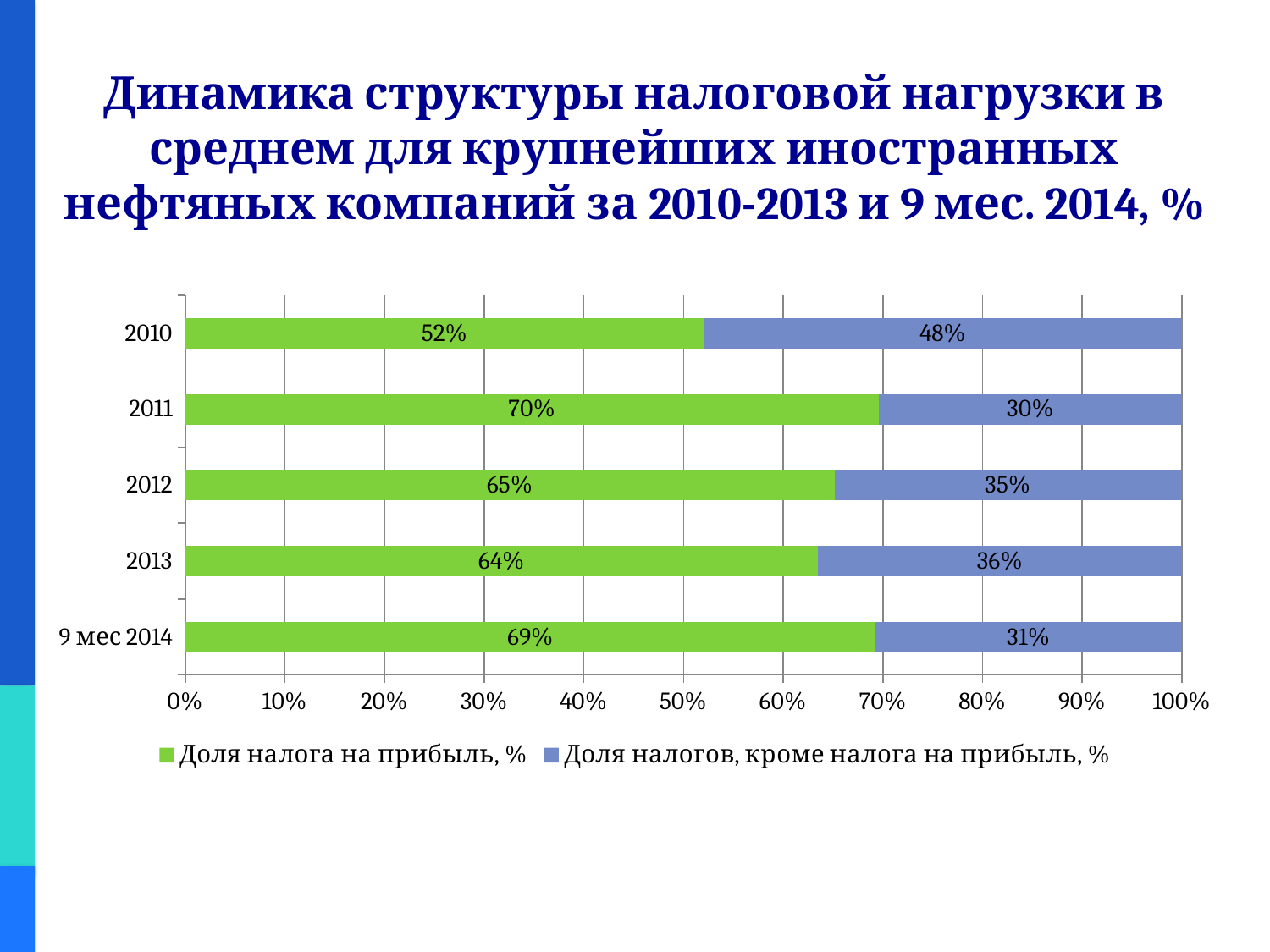
What is the total of the stacked bar for 2012? 100% What kind of chart is shown on the slide? Stacked bar chart How many series does the legend list? 2 How many categories are shown on the y axis? 5 Which category has the lowest value for 'Доля налогов, кроме налога на прибыль, %'? 2011 Which is larger: 'Доля налогов, кроме налога на прибыль, %' in 2012 or in 2013? 2013 What is the value of 'Доля налога на прибыль, %' for 2010? 52% What is the difference between 'Доля налога на прибыль, %' in 2011 and in 2010? 18% What is the value of 'Доля налога на прибыль, %' for 9 мес 2014? 69% Which colour represents 'Доля налога на прибыль, %' in the chart? Green What is the value of 'Доля налогов, кроме налога на прибыль, %' for 2013? 36% Which category has the highest value for 'Доля налога на прибыль, %'? 2011